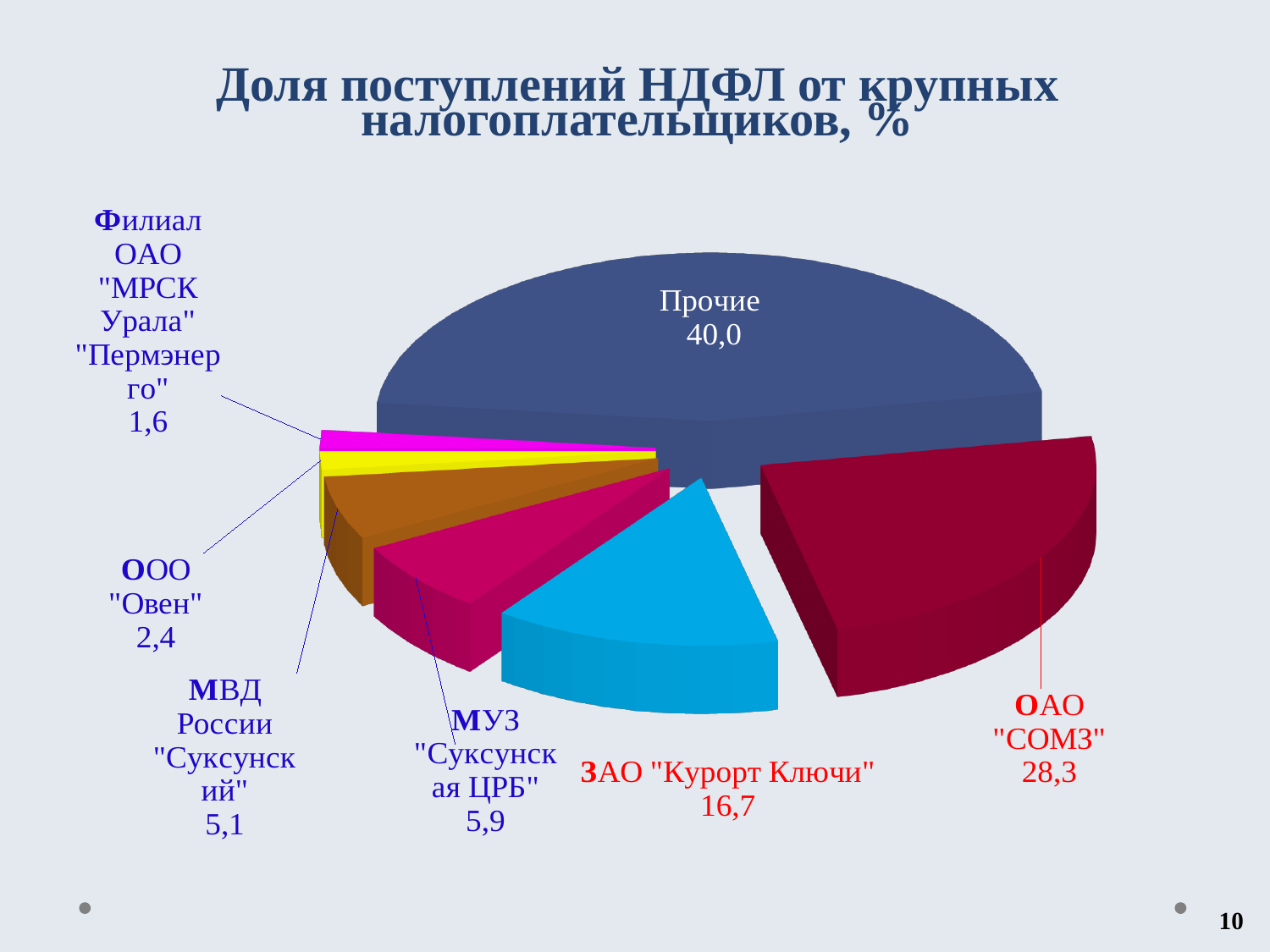
What is the value for ОАО "СОМЗ"? 28,3 What is the title of the chart? Доля поступлений НДФЛ от крупных налогоплательщиков, % How many slices does the pie chart have? 7 What is the value for Прочие? 40,0 Which category has the smallest slice? Филиал ОАО "МРСК Урала" "Пермэнерго" What is the value for МУЗ "Суксунская ЦРБ"? 5,9 Which category has the largest slice? Прочие What type of chart is shown on the slide? Pie chart What is the value for ЗАО "Курорт Ключи"? 16,7 What is the difference between the values for ОАО "СОМЗ" and ЗАО "Курорт Ключи"? 11,6 What is the value for Филиал ОАО "МРСК Урала" "Пермэнерго"? 1,6 Which is larger, the value for МВД России "Суксунский" or the value for ООО "Овен"? МВД России "Суксунский"